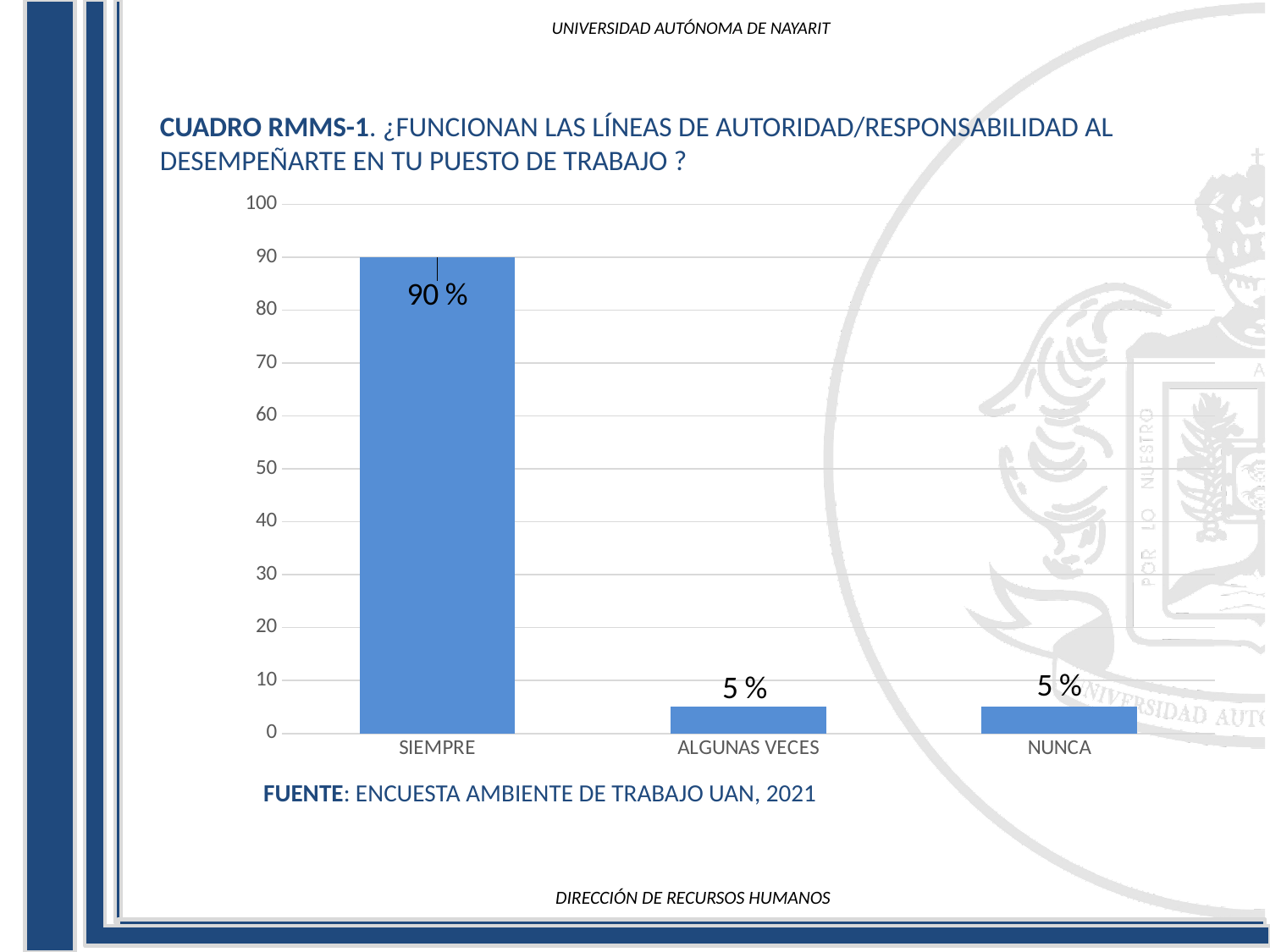
What is the highest value shown on the y axis? 100 Which category has the highest value? SIEMPRE What is the value for ALGUNAS VECES? 5 % How many categories are shown on the x axis? 3 Is the value for SIEMPRE greater or less than 50? greater What is the difference between the values for SIEMPRE and NUNCA? 85 % Which is larger, the value for SIEMPRE or the value for ALGUNAS VECES? SIEMPRE What is the value for NUNCA? 5 % Is the value for NUNCA greater or less than 10? less What is the value for SIEMPRE? 90 % What kind of chart is shown on the slide? bar chart What is the source cited below the chart? ENCUESTA AMBIENTE DE TRABAJO UAN, 2021